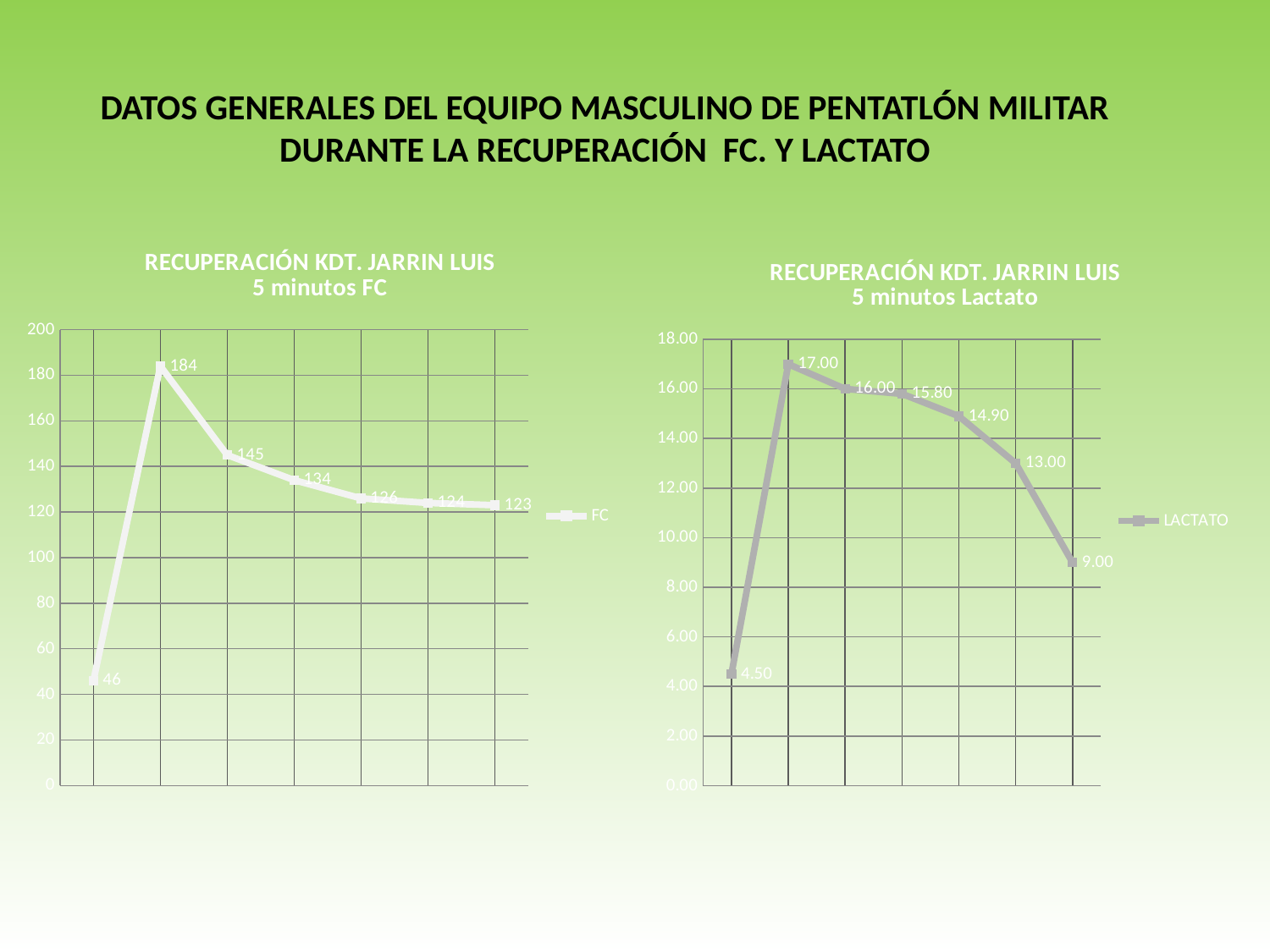
In the '5 minutos Lactato' chart, do the values rise or fall after the second data point? Fall In the '5 minutos Lactato' chart, what is the difference between the peak value (17.00) and the final value (9.00)? 8.00 In the '5 minutos FC' chart, how many data points are plotted? 7 What series name does the legend of the '5 minutos Lactato' chart show? LACTATO In the '5 minutos Lactato' chart, what is the highest value plotted? 17.00 In the '5 minutos Lactato' chart, what is the value of the first data point? 4.50 In the '5 minutos FC' chart, what is the highest value plotted? 184 In the '5 minutos FC' chart, what is the lowest value plotted? 46 In the '5 minutos Lactato' chart, what is the value of the last data point? 9.00 In the '5 minutos FC' chart, what is the difference between the highest value (184) and the first value (46)? 138 What type of chart is the '5 minutos FC' chart? Line chart In the '5 minutos FC' chart, what is the value of the last data point? 123